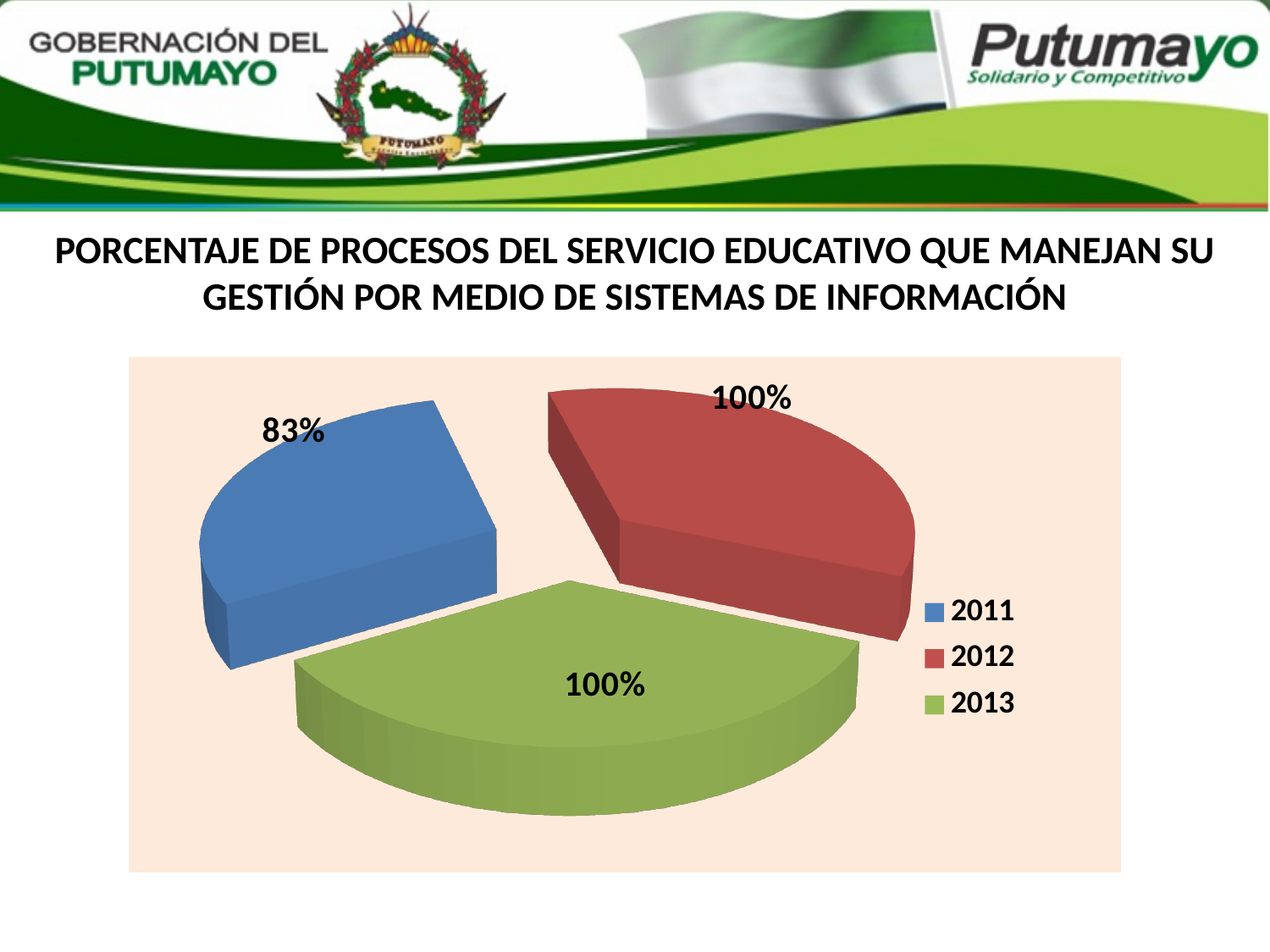
Which colour represents 2013 in the pie chart? Green What value is shown for 2011 in the pie chart? 83% What kind of chart is shown on the slide? Pie chart What is the difference between the value for 2012 and the value for 2011? 17% What value is shown for 2013 in the pie chart? 100% What value is shown for 2012 in the pie chart? 100% How many entries does the legend list? 3 Which year has the lowest value in the pie chart? 2011 Which is larger, the value for 2011 or the value for 2012? 2012 How many slices does the pie chart have? 3 Which year is represented by the blue slice? 2011